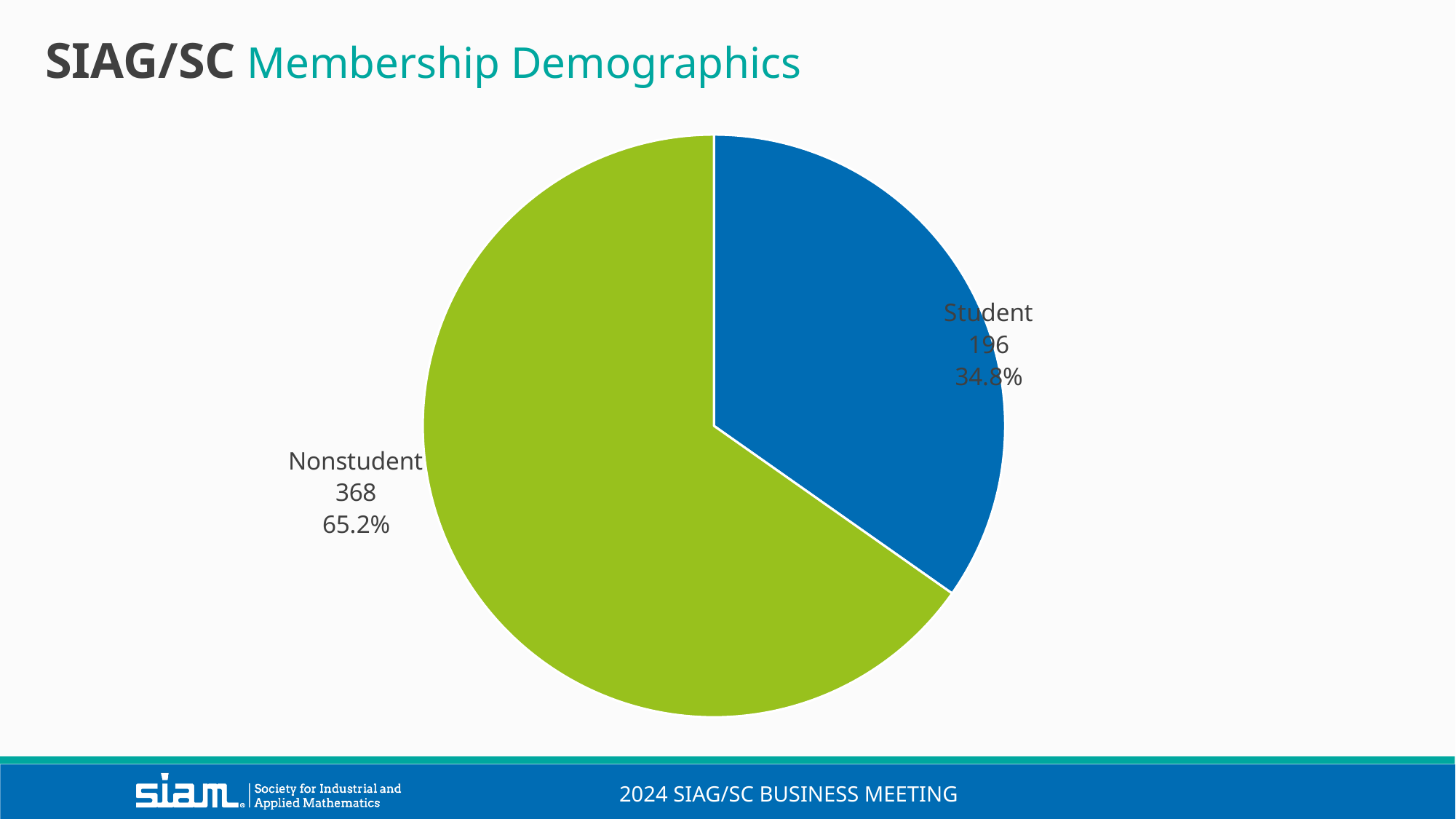
What is the total number of members across both slices? 564 Which is larger, the Student count or the Nonstudent count? Nonstudent Which category has the smallest slice of the pie? Student Which category has the largest slice of the pie? Nonstudent How many members are in the Student category? 196 How many members are in the Nonstudent category? 368 What colour is the Student slice? blue What share of the pie does the Nonstudent slice represent? 65.2% What is the difference in member count between Nonstudent and Student? 172 How many categories are shown in the pie chart? 2 What share of the pie does the Student slice represent? 34.8% What kind of chart is shown on the slide? pie chart